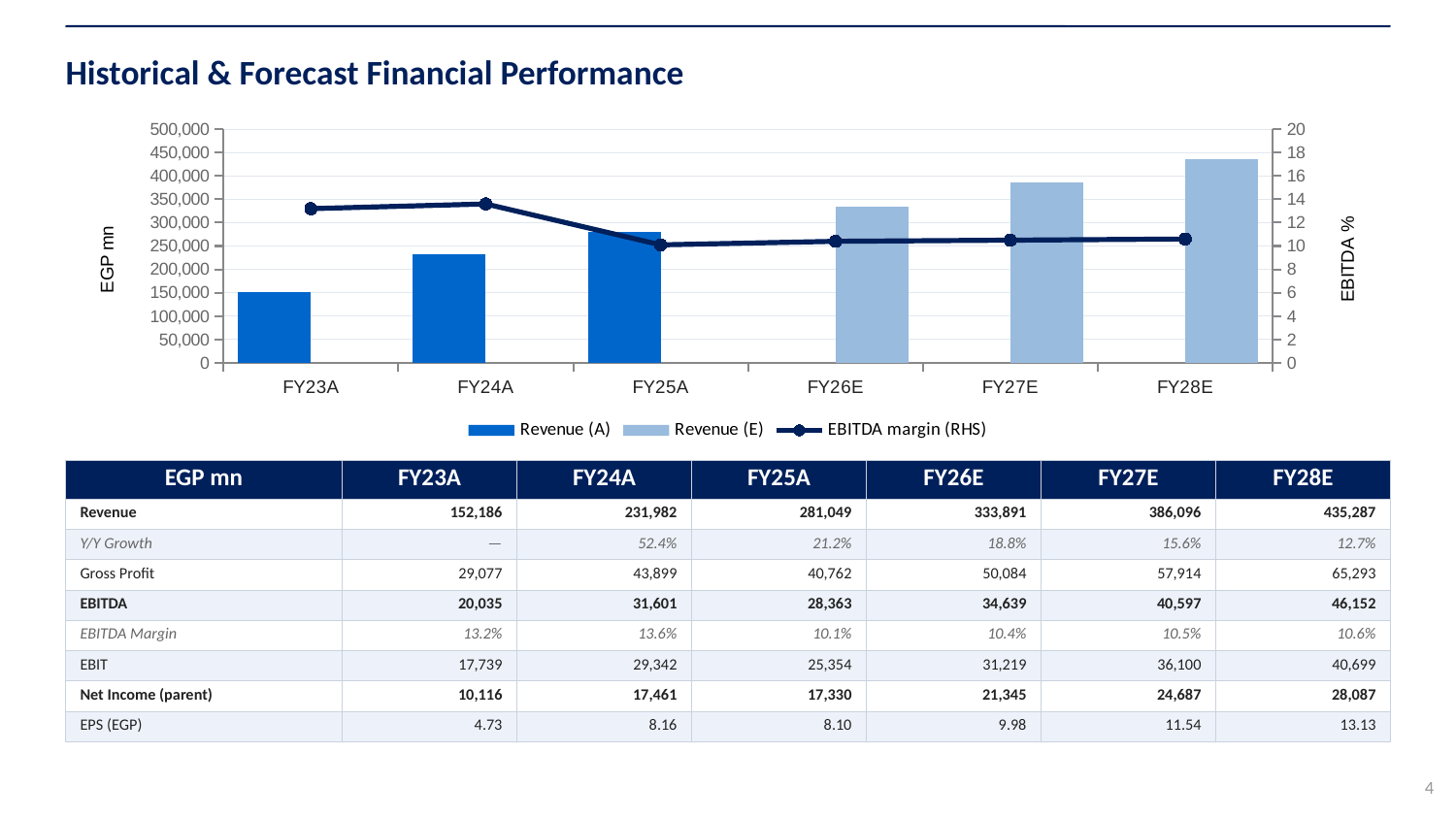
Which series in the chart is plotted on the right-hand axis? EBITDA margin (RHS) Do the revenue bars rise or fall from FY23A to FY28E? Rise Which fiscal year has the shortest revenue bar in the chart? FY23A Is the revenue bar for FY28E greater or less than 400,000 EGP mn? greater According to the table, what is the revenue for FY26E? 333,891 How many fiscal years are shown on the x axis of the chart? 6 Is the EBITDA margin point for FY24A greater or less than 12%? greater Is the revenue bar for FY23A greater or less than 200,000 EGP mn? less Which fiscal year has the tallest revenue bar in the chart? FY28E Which year has the higher EBITDA margin in the chart, FY24A or FY25A? FY24A How many series does the chart legend list? 3 What kind of chart is shown on the slide? A combination bar and line chart